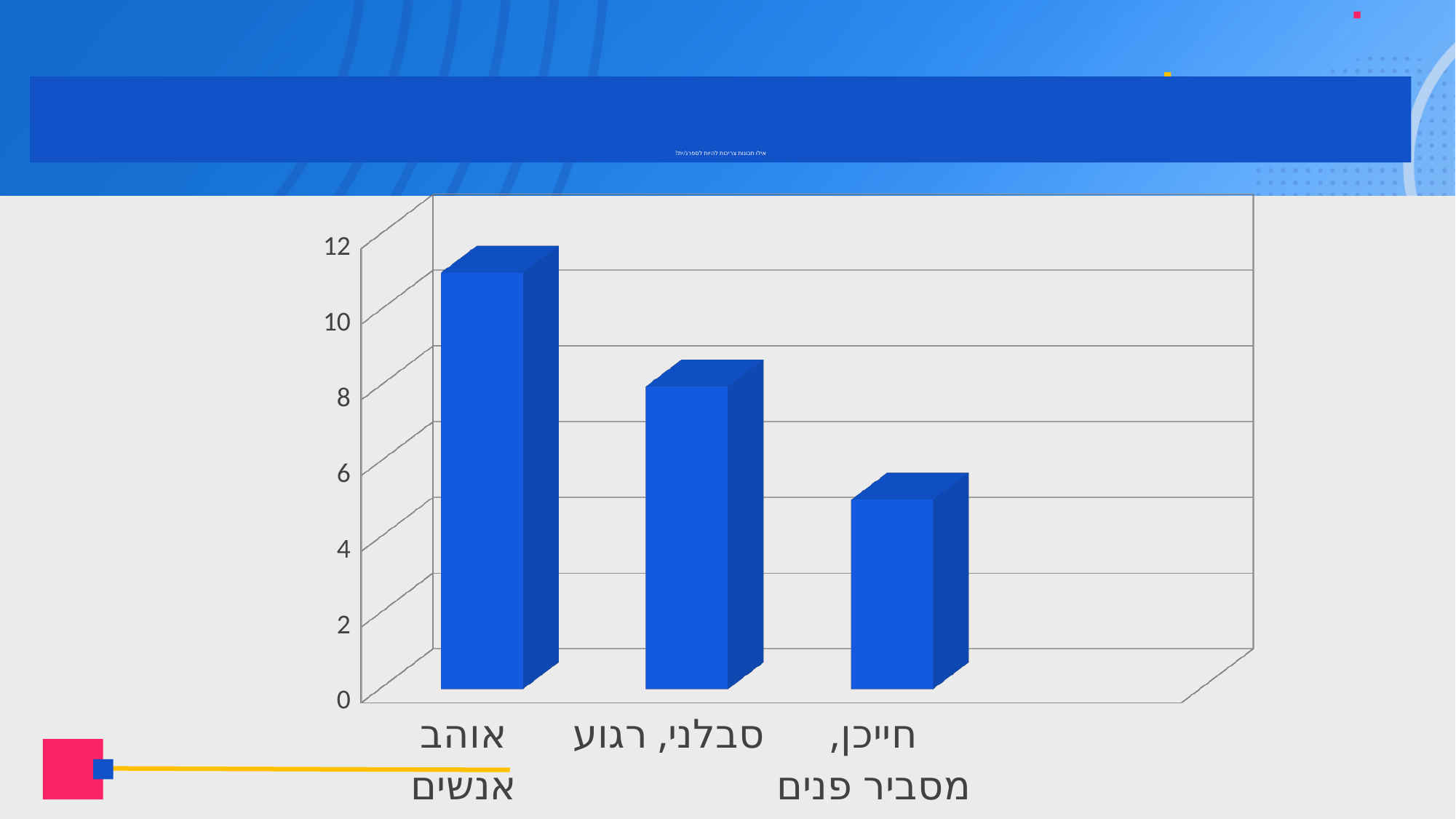
What colour are the bars in the chart? blue Which category has the highest bar? אוהב אנשים How many categories are shown on the x axis of the chart? 3 Is the value for חייכן, מסביר פנים greater or less than 4? greater Is the value for חייכן, מסביר פנים greater or less than 6? less Is the value for סבלני, רגוע greater or less than 10? less Which category has the lowest bar? חייכן, מסביר פנים Reading the bars from left to right, do the values rise or fall? fall What kind of chart is shown on the slide? bar chart Which is larger, the value for סבלני, רגוע or the value for חייכן, מסביר פנים? סבלני, רגוע